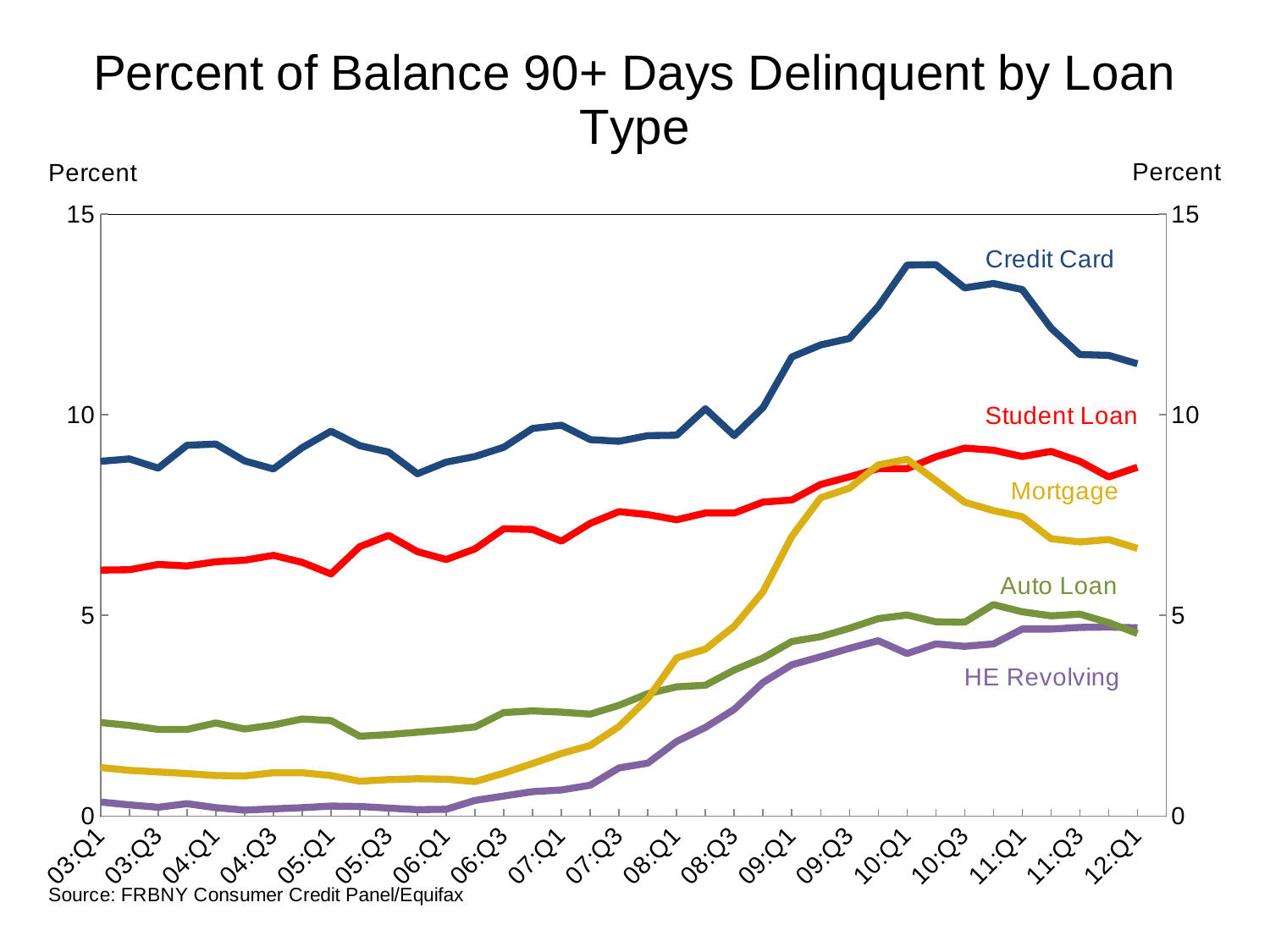
Is the Mortgage value at 03:Q1 greater or less than 5? less At 12:Q1, which is larger: the Student Loan value or the Mortgage value? Student Loan Which loan type has the highest delinquency rate at 12:Q1? Credit Card How many loan types are plotted as lines on the chart? 5 Is the Credit Card value at 03:Q1 greater or less than 10? less Is the Credit Card value at 10:Q1 greater or less than 10? greater What is the source cited below the chart? FRBNY Consumer Credit Panel/Equifax What kind of chart is shown on the slide? Line chart Which loan type has the lowest delinquency rate at 03:Q1? HE Revolving Does the Credit Card line rise or fall between 10:Q1 and 12:Q1? Fall Does the Mortgage line rise or fall between 03:Q1 and 10:Q1? Rise